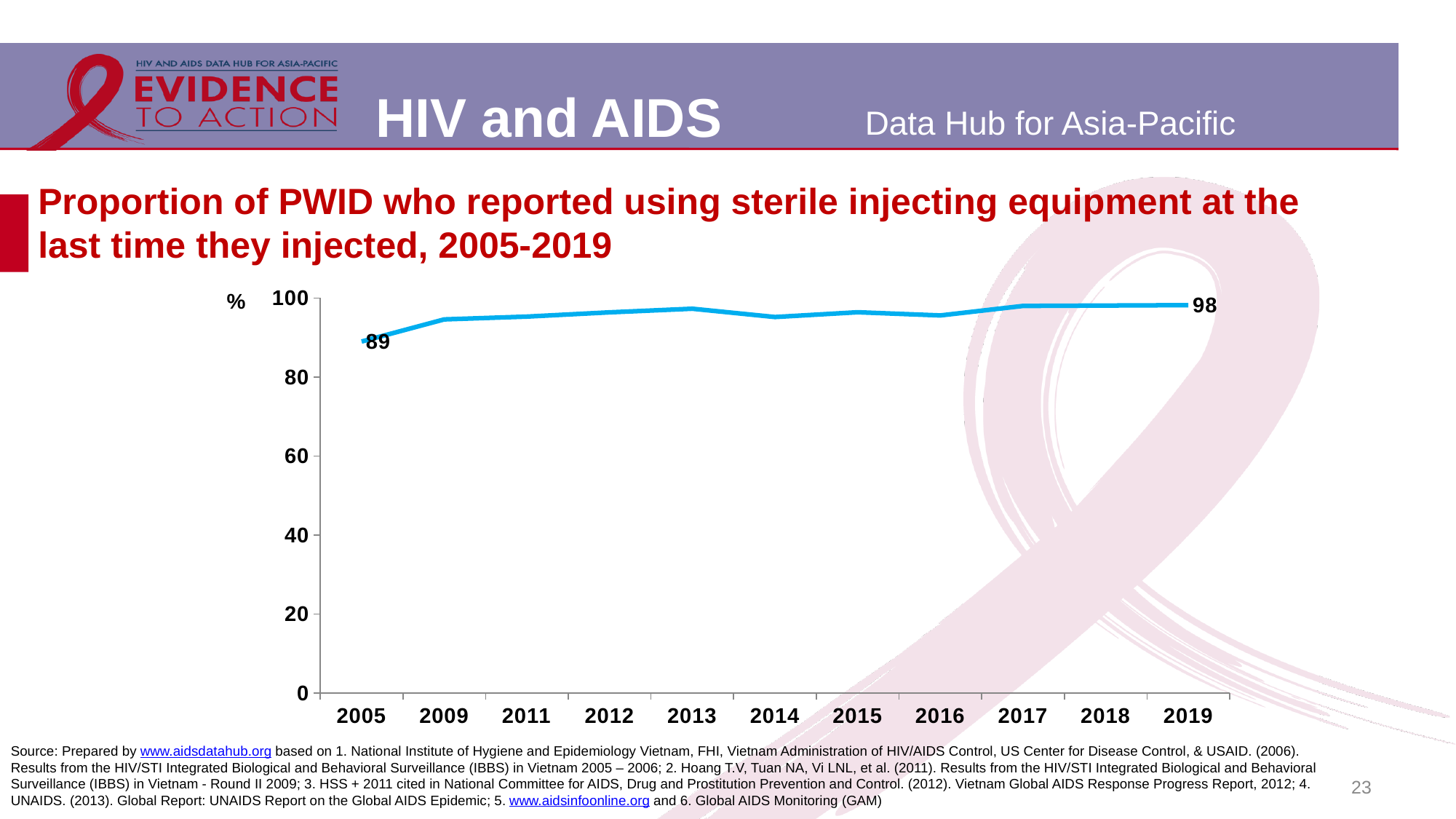
Is the value for 2009 greater or less than 60? greater Which is larger, the value for 2005 or the value for 2019? 2019 What kind of chart is shown on the slide? Line chart How many years are shown on the x axis? 11 What unit is shown on the y axis of the chart? % What is the difference between the values for 2019 and 2005? 9 What is the value for 2019? 98 What is the first year shown on the x axis? 2005 What is the value for 2005? 89 Do the values generally rise or fall from 2005 to 2019? Rise Is the value for 2013 greater or less than 80? greater Which year has the lowest value on the chart? 2005